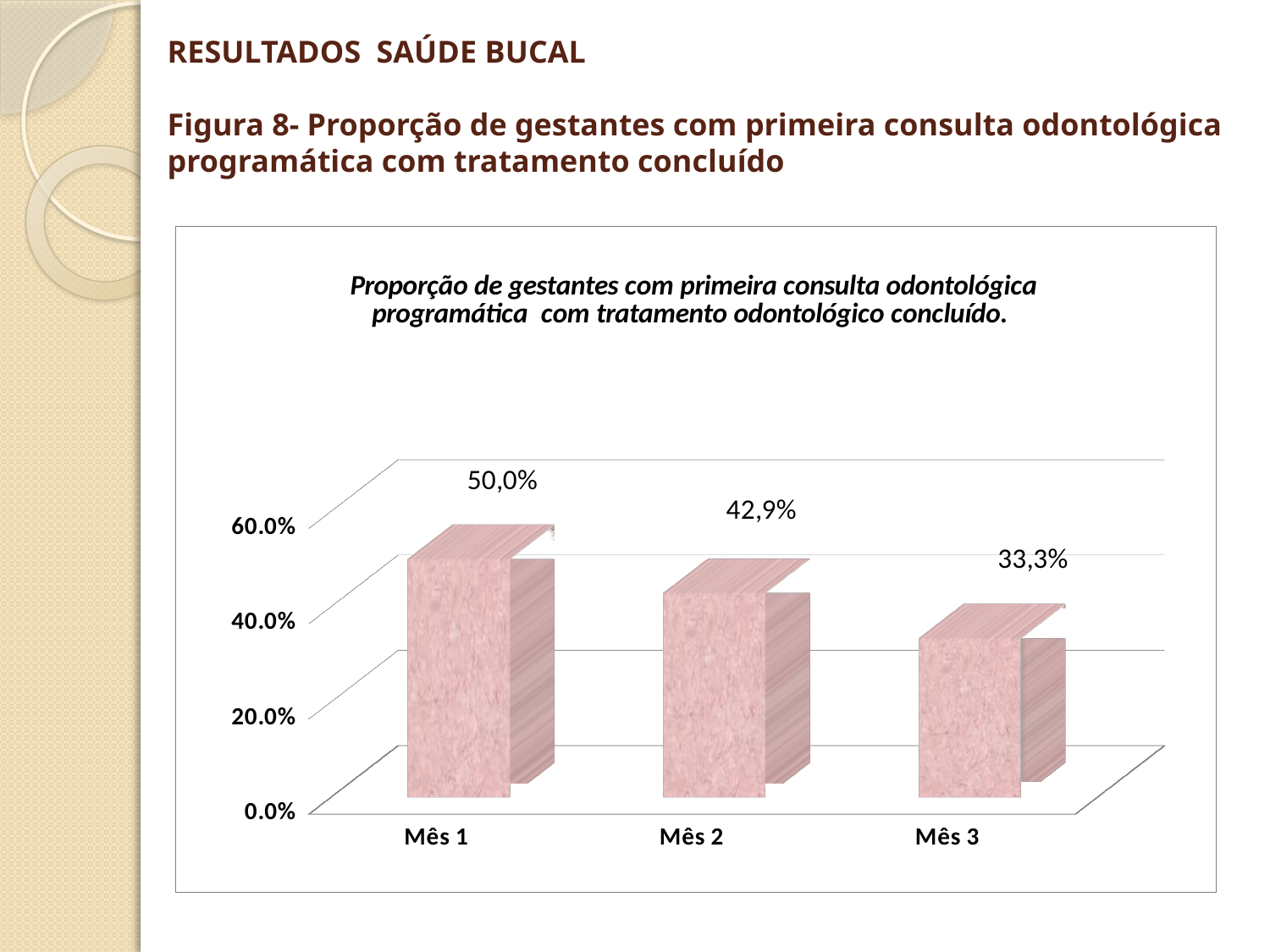
What is the value for Mês 1? 50,0% What kind of chart is shown on the slide? bar chart What is the value for Mês 2? 42,9% What is the value for Mês 3? 33,3% Which is larger, the value for Mês 2 or the value for Mês 3? Mês 2 What is the difference between the values for Mês 1 and Mês 3? 16,7% Which month has the lowest value? Mês 3 What is the difference between the values for Mês 1 and Mês 2? 7,1% Which month has the highest value? Mês 1 Do the values rise or fall from Mês 1 to Mês 3? fall How many categories are shown on the x axis? 3 Is the value for Mês 2 greater or less than 40.0%? greater